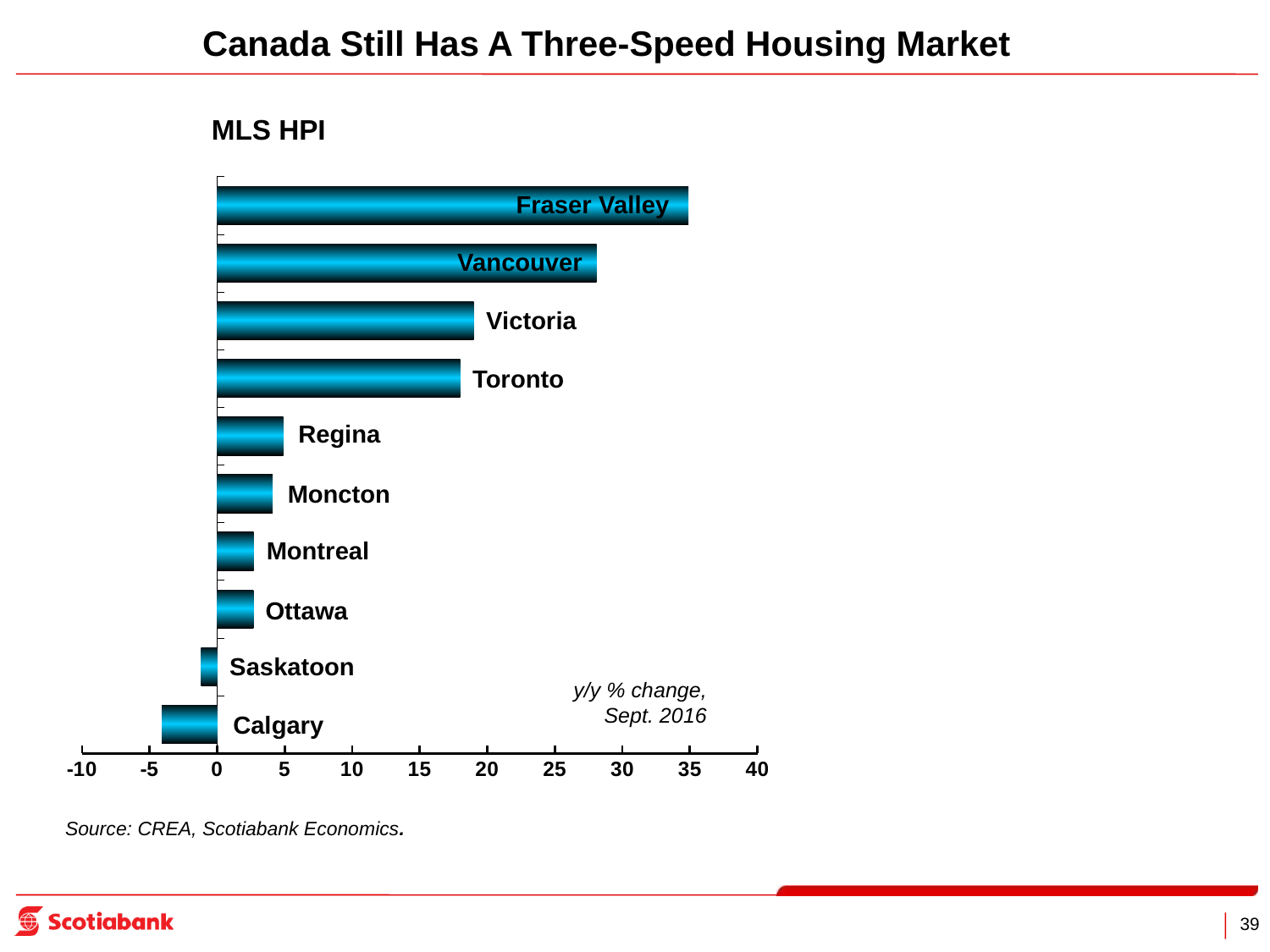
Which has a larger y/y % change, Vancouver or Victoria? Vancouver Which has a larger y/y % change, Toronto or Regina? Toronto Which city or region has the highest y/y % change in the MLS HPI? Fraser Valley How many cities or regions are plotted in the chart? 10 Which city or region has the lowest y/y % change in the MLS HPI? Calgary Is the value for Calgary greater or less than 0? less Is the value for Toronto greater or less than 20? less Is the value for Fraser Valley greater or less than 30? greater What kind of chart is shown on the slide? bar chart How many cities or regions show a negative y/y % change? 2 What is the title of the chart? MLS HPI